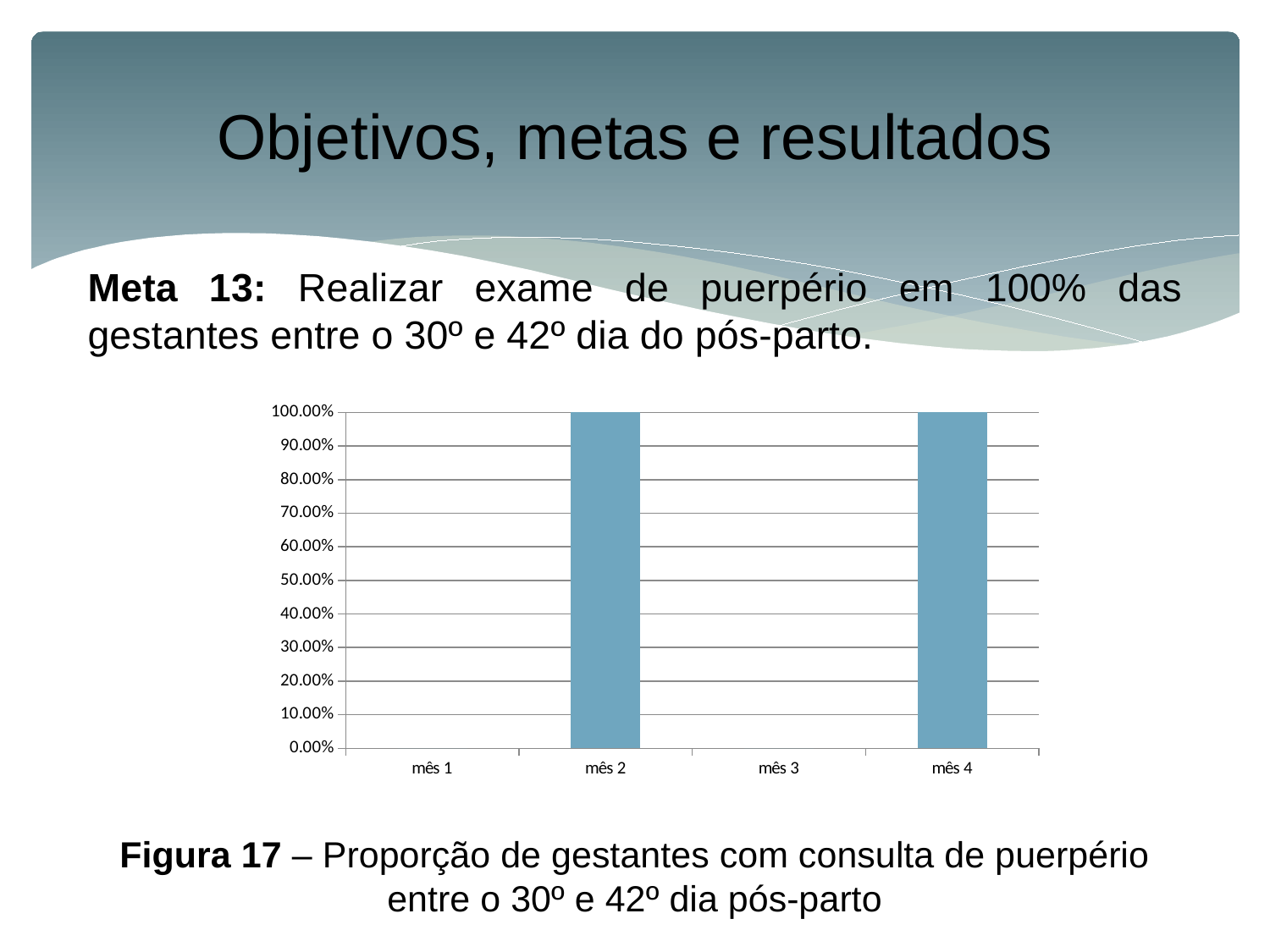
Is the value for mês 3 greater or less than 10.00%? less What is the figure number given in the caption below the chart? Figura 17 Is the value for mês 1 greater or less than 50.00%? less What is the value for mês 2 in the chart? 100.00% What kind of chart is shown on the slide? bar chart Is the value for mês 2 greater or less than 90.00%? greater What is the highest value shown on the y axis of the chart? 100.00% What is the difference between the values for mês 2 and mês 4? 0.00% How many categories are shown on the x axis of the chart? 4 What is the value for mês 4 in the chart? 100.00% Which is larger, the value for mês 2 or the value for mês 3? mês 2 Which is larger, the value for mês 1 or the value for mês 4? mês 4